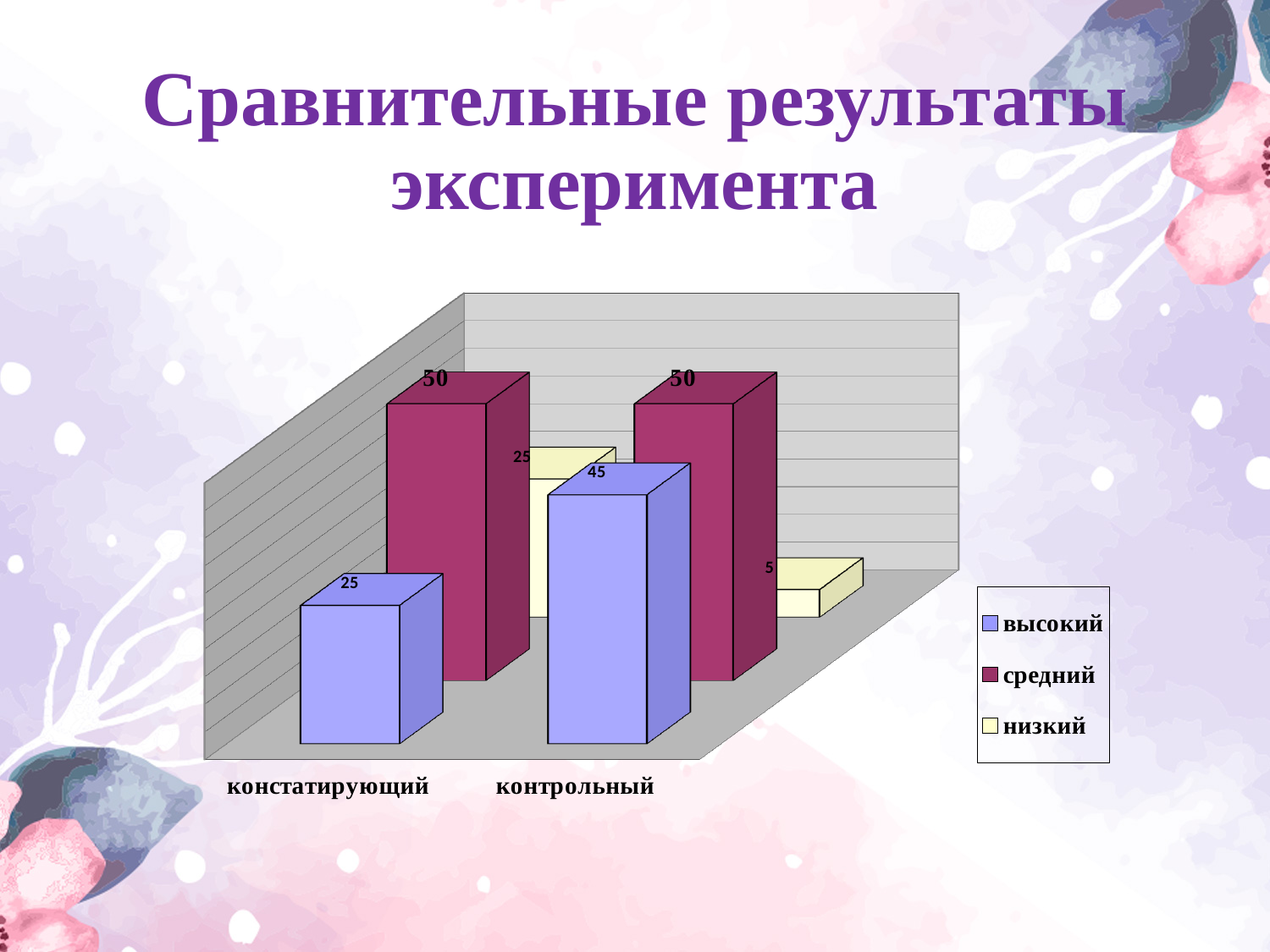
What is the difference between the высокий values for контрольный and констатирующий? 20 What kind of chart is shown on the slide? bar chart What is the value for высокий in the констатирующий category? 25 What is the value for низкий in the констатирующий category? 25 What is the value for высокий in the контрольный category? 45 What is the value for средний in the констатирующий category? 50 Which is larger: низкий for констатирующий or низкий for контрольный? констатирующий How many categories are shown on the x axis? 2 Which series has the lowest value in the контрольный category? низкий Which series has the highest value in the констатирующий category? средний What is the value for низкий in the контрольный category? 5 How many series does the legend list? 3